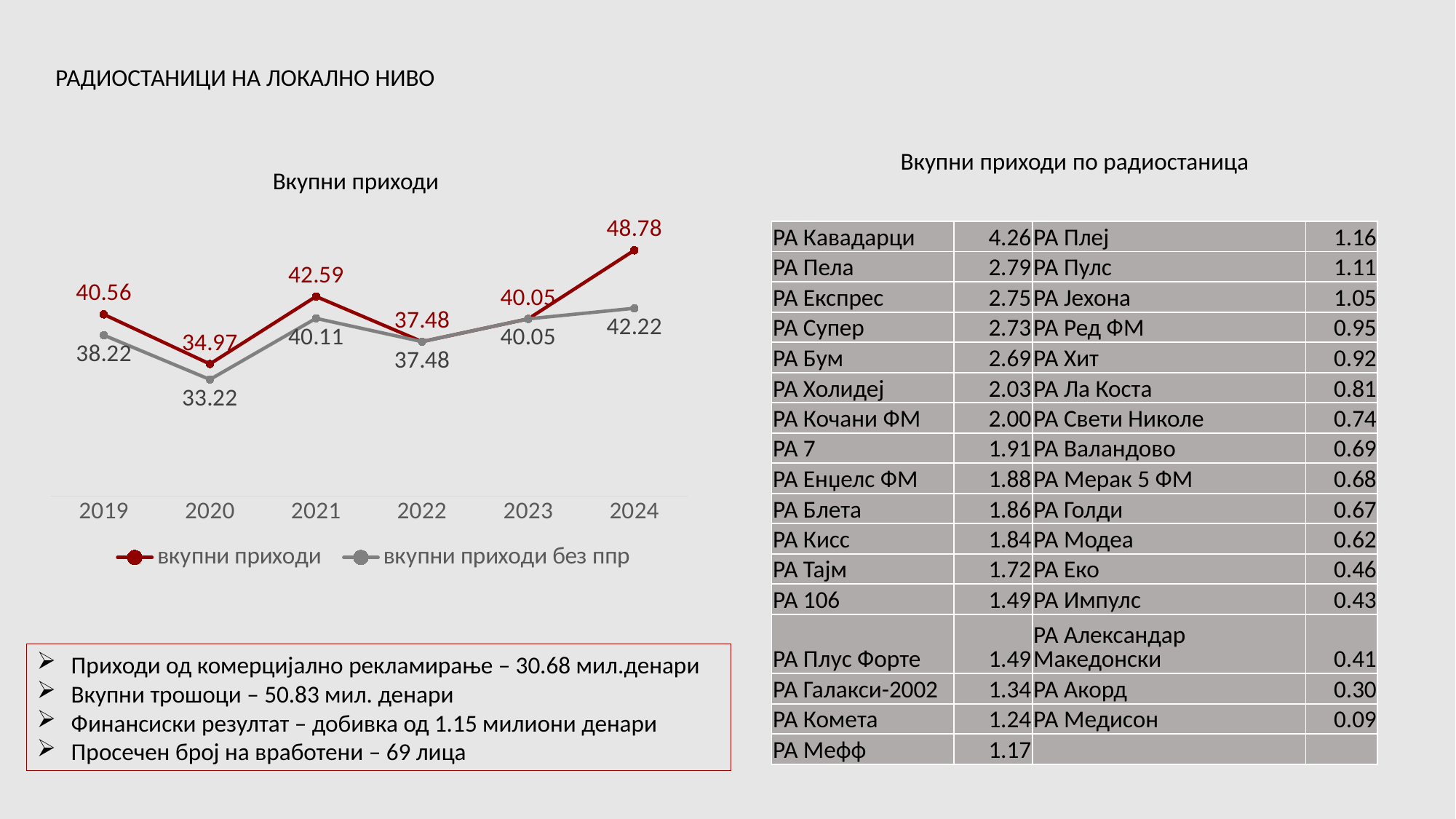
In the "Вкупни приходи" chart, what is the value of "вкупни приходи без ппр" for 2020? 33.22 In the "Вкупни приходи" chart, does "вкупни приходи" rise or fall from 2023 to 2024? rise In the "Вкупни приходи" chart, what is the value of "вкупни приходи" for 2021? 42.59 How many years are shown on the x axis of the "Вкупни приходи" chart? 6 In the "Вкупни приходи" chart, what is the difference between the "вкупни приходи" values for 2019 and 2020? 5.59 How many series does the legend of the "Вкупни приходи" chart list? 2 In the "Вкупни приходи" chart, which is larger: "вкупни приходи" in 2021 or in 2023? 2021 In the "Вкупни приходи" chart, which year has the lowest value for "вкупни приходи без ппр"? 2020 In the "Вкупни приходи" chart, what is the value of "вкупни приходи" for 2024? 48.78 In the "Вкупни приходи" chart, what is the difference between "вкупни приходи" and "вкупни приходи без ппр" in 2024? 6.56 In the "Вкупни приходи" chart, which year has the highest value for "вкупни приходи"? 2024 What type of chart is "Вкупни приходи"? line chart